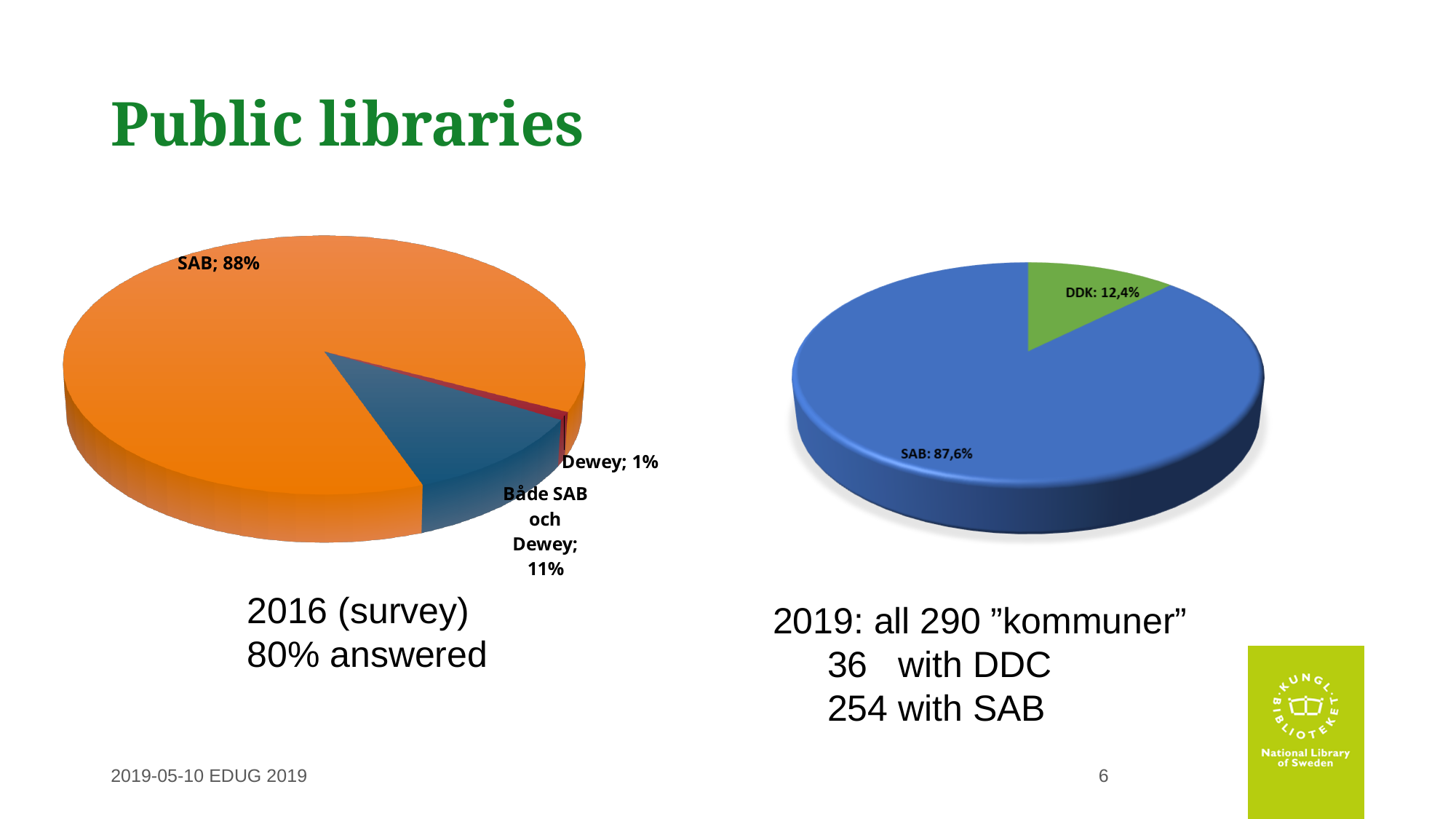
In the right pie chart (2019), which category has the smaller slice? DDK What type of chart is shown on the right side of the slide? Pie chart In the left pie chart (2016 survey), what share is labelled for Dewey? 1% In the right pie chart (2019), what share is labelled for SAB? 87,6% In the left pie chart (2016 survey), which category has the smallest slice? Dewey In the left pie chart (2016 survey), what is the difference between the SAB share and the 'Både SAB och Dewey' share? 77% How many slices does the right pie chart (2019) have? 2 In the left pie chart (2016 survey), what share is labelled for 'Både SAB och Dewey'? 11% In the left pie chart (2016 survey), which category has the largest slice? SAB In the right pie chart (2019), what share is labelled for DDK? 12,4% How many slices does the left pie chart (2016 survey) have? 3 In the left pie chart (2016 survey), what share is labelled for SAB? 88%